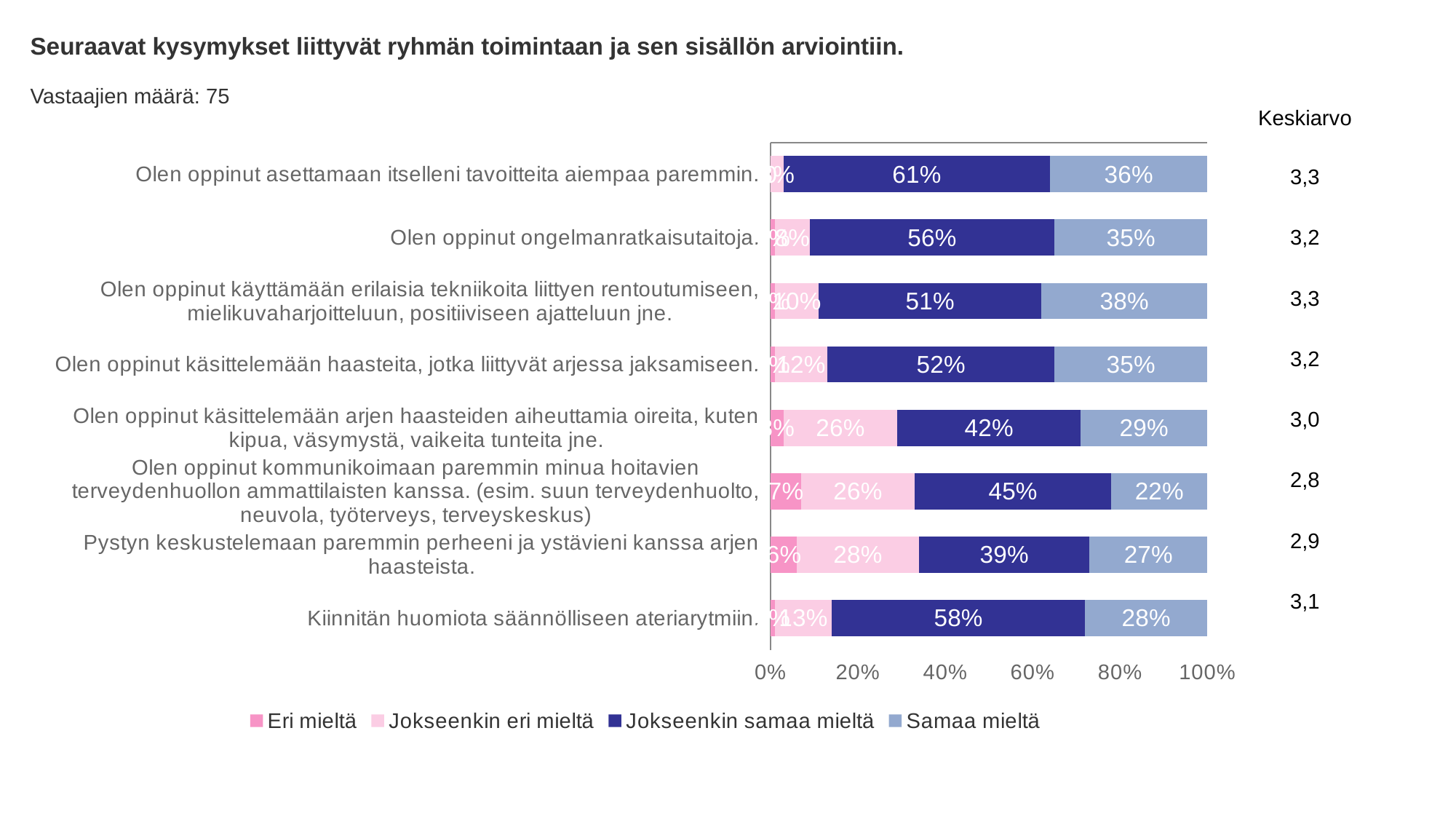
What is the Keskiarvo (mean) shown for 'Olen oppinut kommunikoimaan paremmin minua hoitavien terveydenhuollon ammattilaisten kanssa. (esim. suun terveydenhuolto, neuvola, työterveys, terveyskeskus)'? 2,8 Which statement has the highest 'Jokseenkin samaa mieltä' value? Olen oppinut asettamaan itselleni tavoitteita aiempaa paremmin. What is the 'Jokseenkin eri mieltä' value for 'Pystyn keskustelemaan paremmin perheeni ja ystävieni kanssa arjen haasteista.'? 28% What is the 'Samaa mieltä' value for 'Olen oppinut ongelmanratkaisutaitoja.'? 35% How many series does the legend list? 4 What kind of chart is shown on the slide? Stacked bar chart What is the 'Jokseenkin samaa mieltä' value for 'Olen oppinut asettamaan itselleni tavoitteita aiempaa paremmin.'? 61% How many categories (statements) are plotted in the chart? 8 What is the 'Jokseenkin samaa mieltä' value for 'Kiinnitän huomiota säännölliseen ateriarytmiin.'? 58% What is the difference between the 'Samaa mieltä' values for 'Olen oppinut käyttämään erilaisia tekniikoita liittyen rentoutumiseen, mielikuvaharjoitteluun, positiiviseen ajatteluun jne.' (38%) and 'Olen oppinut käsittelemään arjen haasteiden aiheuttamia oireita, kuten kipua, väsymystä, vaikeita tunteita jne.' (29%)? 9% Which is larger: the 'Jokseenkin samaa mieltä' value for 'Olen oppinut käsittelemään haasteita, jotka liittyvät arjessa jaksamiseen.' or for 'Pystyn keskustelemaan paremmin perheeni ja ystävieni kanssa arjen haasteista.'? Olen oppinut käsittelemään haasteita, jotka liittyvät arjessa jaksamiseen. Which statement has the lowest 'Samaa mieltä' value? Olen oppinut kommunikoimaan paremmin minua hoitavien terveydenhuollon ammattilaisten kanssa. (esim. suun terveydenhuolto, neuvola, työterveys, terveyskeskus)